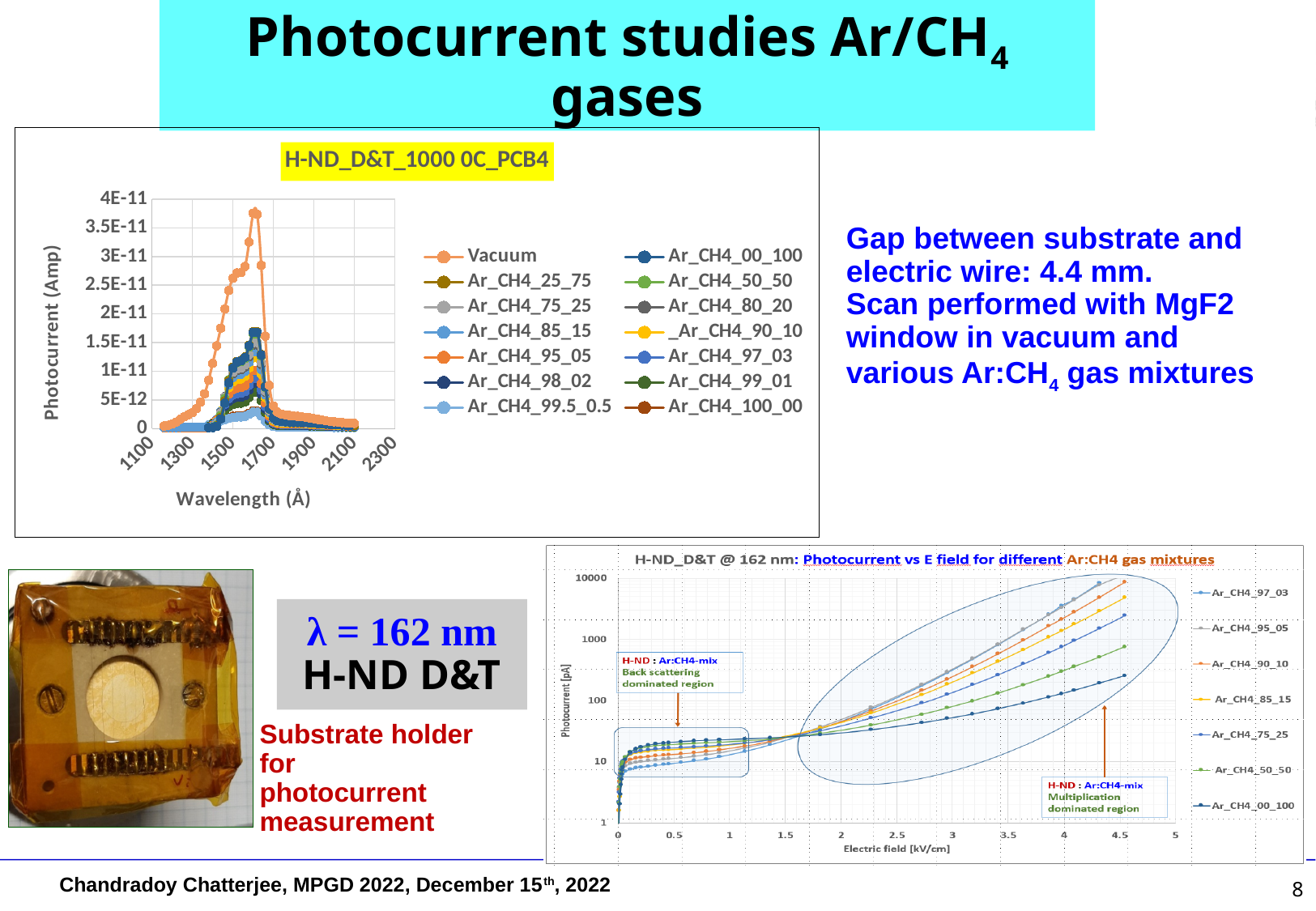
In the bottom-right chart (Photocurrent vs E field for different Ar:CH4 gas mixtures), how many series does the legend list? 7 In the top-left chart (H-ND_D&T_1000 0C_PCB4), is the peak photocurrent of the Vacuum series greater or less than 3.5E-11? greater In the top-left chart (H-ND_D&T_1000 0C_PCB4), what is the label of the x axis? Wavelength (Å) In the top-left chart (H-ND_D&T_1000 0C_PCB4), which series reaches the highest photocurrent? Vacuum In the bottom-right chart (Photocurrent vs E field for different Ar:CH4 gas mixtures), is the photocurrent of Ar_CH4_97_03 at 4.5 kV/cm greater or less than 1000 pA? greater What kind of chart is the bottom-right chart (Photocurrent vs E field for different Ar:CH4 gas mixtures)? line chart In the bottom-right chart (Photocurrent vs E field for different Ar:CH4 gas mixtures), does the photocurrent rise or fall as the electric field increases above 2 kV/cm? rise What kind of chart is the top-left chart titled H-ND_D&T_1000 0C_PCB4? line chart In the bottom-right chart (Photocurrent vs E field for different Ar:CH4 gas mixtures), is the photocurrent of Ar_CH4_00_100 at 4.5 kV/cm greater or less than 100 pA? greater In the top-left chart (H-ND_D&T_1000 0C_PCB4), how many series does the legend list? 14 In the bottom-right chart (Photocurrent vs E field for different Ar:CH4 gas mixtures), which series has the lowest photocurrent at the highest electric field values? Ar_CH4_00_100 In the top-left chart (H-ND_D&T_1000 0C_PCB4), what is the label of the y axis? Photocurrent (Amp)